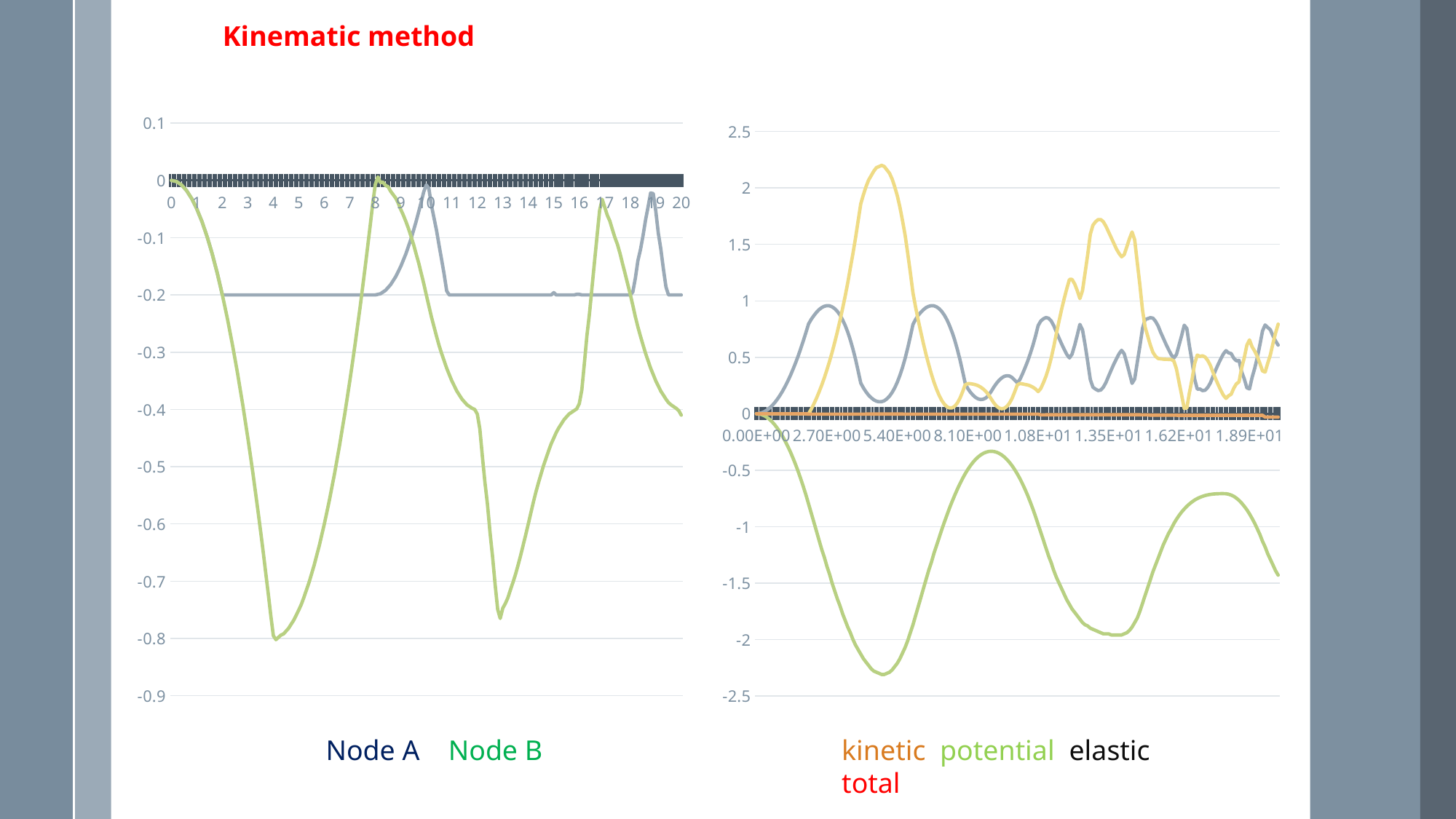
What kind of chart is the left chart on the slide? line chart How many series does the legend of the right chart list? 4 On the left chart, which series reaches the lowest value? Node B On the left chart, is the value for Node B at x = 4 greater or less than -0.7? less On the left chart, is the value for Node A at x = 5 greater or less than -0.1? less What is the title shown above the charts on the slide? Kinematic method On the left chart, does the Node B line rise or fall between x = 0 and x = 4? fall On the left chart, at x = 4, which series has the higher value, Node A or Node B? Node A What kind of chart is the right chart on the slide? line chart On the right chart, is the peak of the yellow line near 5.40E+00 greater or less than 2? greater How many series does the legend of the left chart list? 2